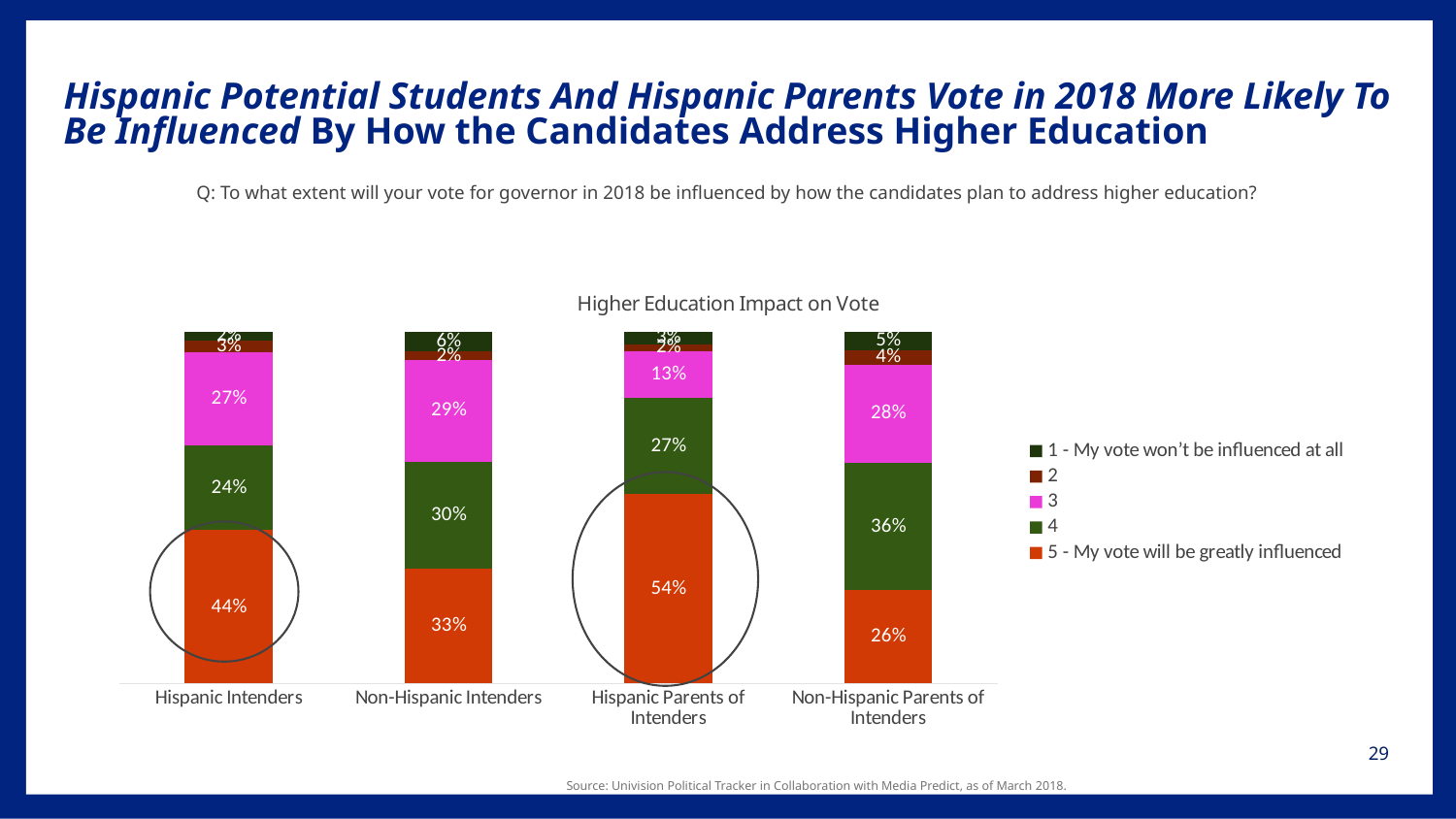
How many categories are shown along the x axis of the chart? 4 What percentage of Non-Hispanic Intenders answered '3'? 29% Which category has the highest share answering '5 - My vote will be greatly influenced'? Hispanic Parents of Intenders What is the difference between the '5 - My vote will be greatly influenced' share for Hispanic Parents of Intenders and Non-Hispanic Parents of Intenders? 28 percentage points Which category has the lowest share answering '5 - My vote will be greatly influenced'? Non-Hispanic Parents of Intenders What type of chart is shown on the slide? Stacked bar chart How many series does the chart's legend list? 5 What is the title of the chart? Higher Education Impact on Vote What percentage of Non-Hispanic Parents of Intenders answered '4'? 36% What percentage of Hispanic Parents of Intenders answered '5 - My vote will be greatly influenced'? 54% What percentage of Hispanic Intenders answered '5 - My vote will be greatly influenced'? 44% Which is larger: the '4' share for Non-Hispanic Intenders or the '4' share for Hispanic Intenders? Non-Hispanic Intenders